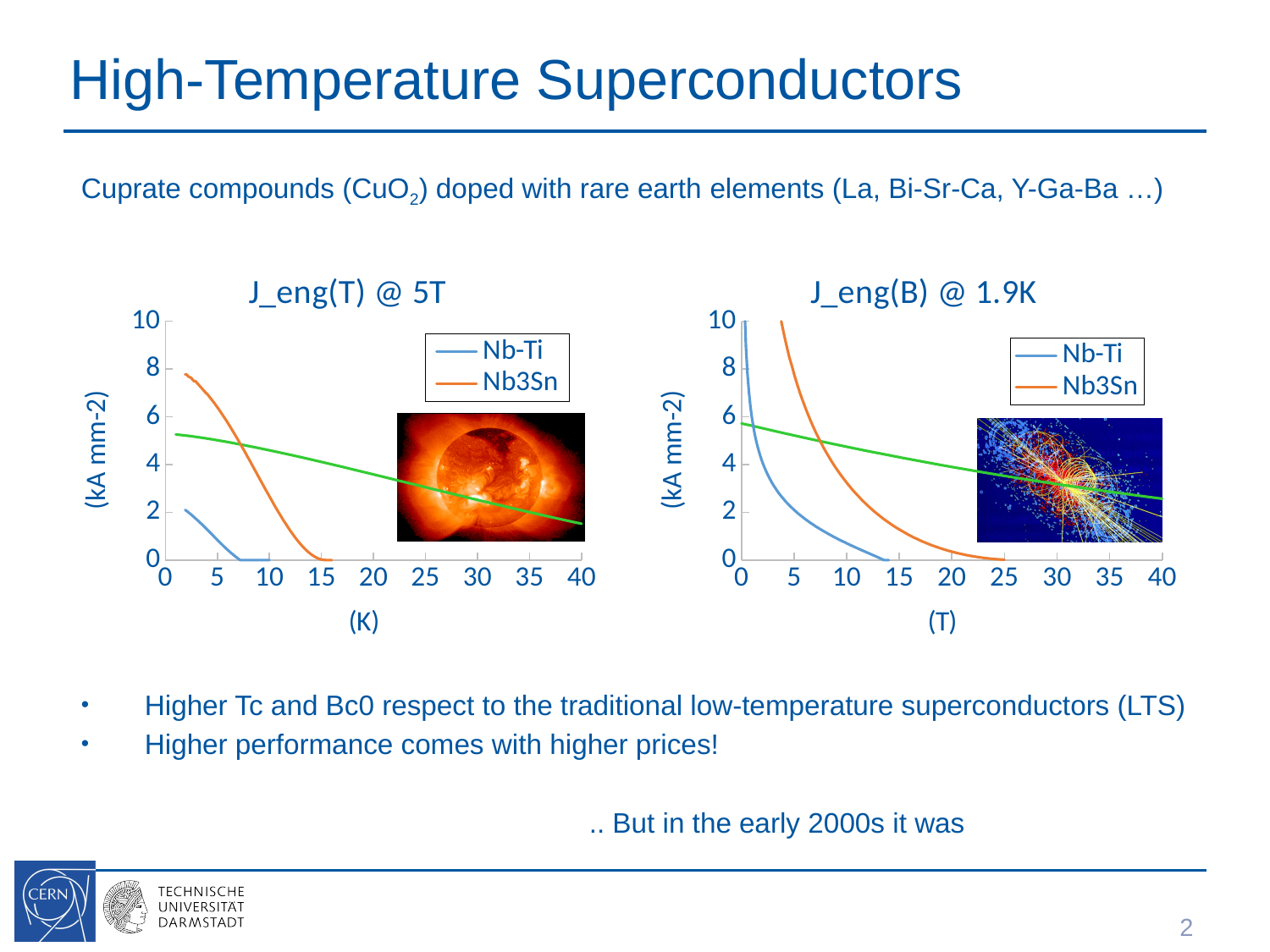
In the right chart "J_eng(B) @ 1.9K", does the Nb-Ti curve rise or fall as the field increases along the x axis? fall How many series does the legend of the left chart "J_eng(T) @ 5T" list? 2 In the left chart "J_eng(T) @ 5T", does the Nb3Sn curve rise or fall as temperature increases along the x axis? fall What is the y-axis label of the right chart "J_eng(B) @ 1.9K"? (kA mm-2) In the right chart "J_eng(B) @ 1.9K", is the Nb-Ti value at 10 T greater or less than 2? less What kind of chart is the left chart titled "J_eng(T) @ 5T"? line chart In the right chart "J_eng(B) @ 1.9K", is the Nb3Sn value at 5 T greater or less than 6? less In the left chart "J_eng(T) @ 5T", is the Nb-Ti value at 5 K greater or less than 2? less In the right chart "J_eng(B) @ 1.9K", which two series are named in the legend? Nb-Ti and Nb3Sn In the left chart "J_eng(T) @ 5T", which series has the larger value at 5 K, Nb-Ti or Nb3Sn? Nb3Sn